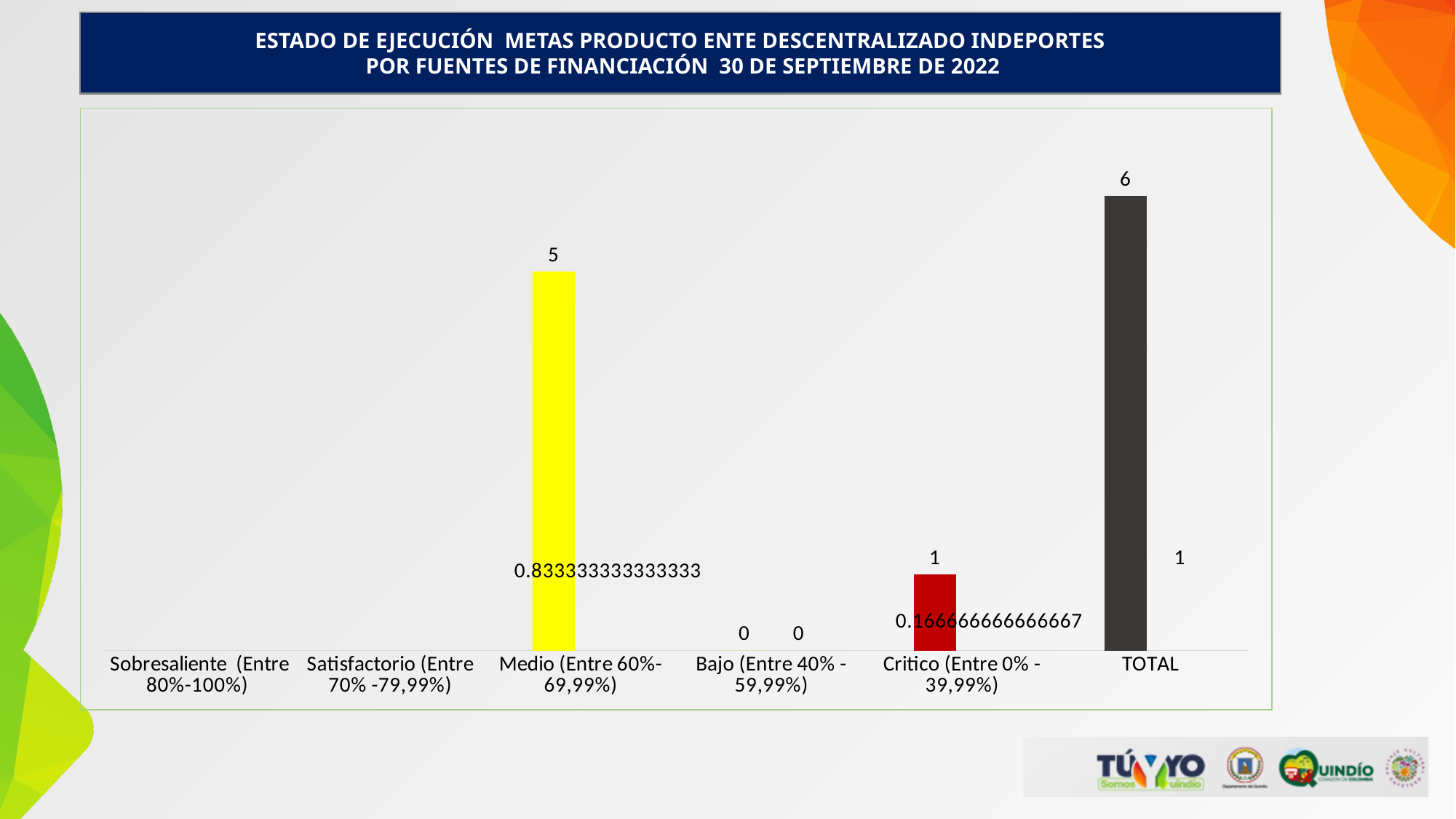
What value is labelled for Bajo (Entre 40% - 59,99%)? 0 Excluding TOTAL, which category has the highest bar? Medio (Entre 60%-69,99%) What is the value shown above the bar for Medio (Entre 60%-69,99%)? 5 How many categories are shown on the x axis? 6 What proportion value is printed next to the Medio (Entre 60%-69,99%) bar? 0.833333333333333 Which category has the tallest bar? TOTAL What proportion value is printed next to the Critico (Entre 0% - 39,99%) bar? 0.166666666666667 What type of chart is shown on the slide? Bar chart Which is larger, the value for Medio (Entre 60%-69,99%) or the value for Critico (Entre 0% - 39,99%)? Medio (Entre 60%-69,99%) What is the value shown above the TOTAL bar? 6 What is the difference between the TOTAL value and the Medio (Entre 60%-69,99%) value? 1 What is the value shown above the bar for Critico (Entre 0% - 39,99%)? 1